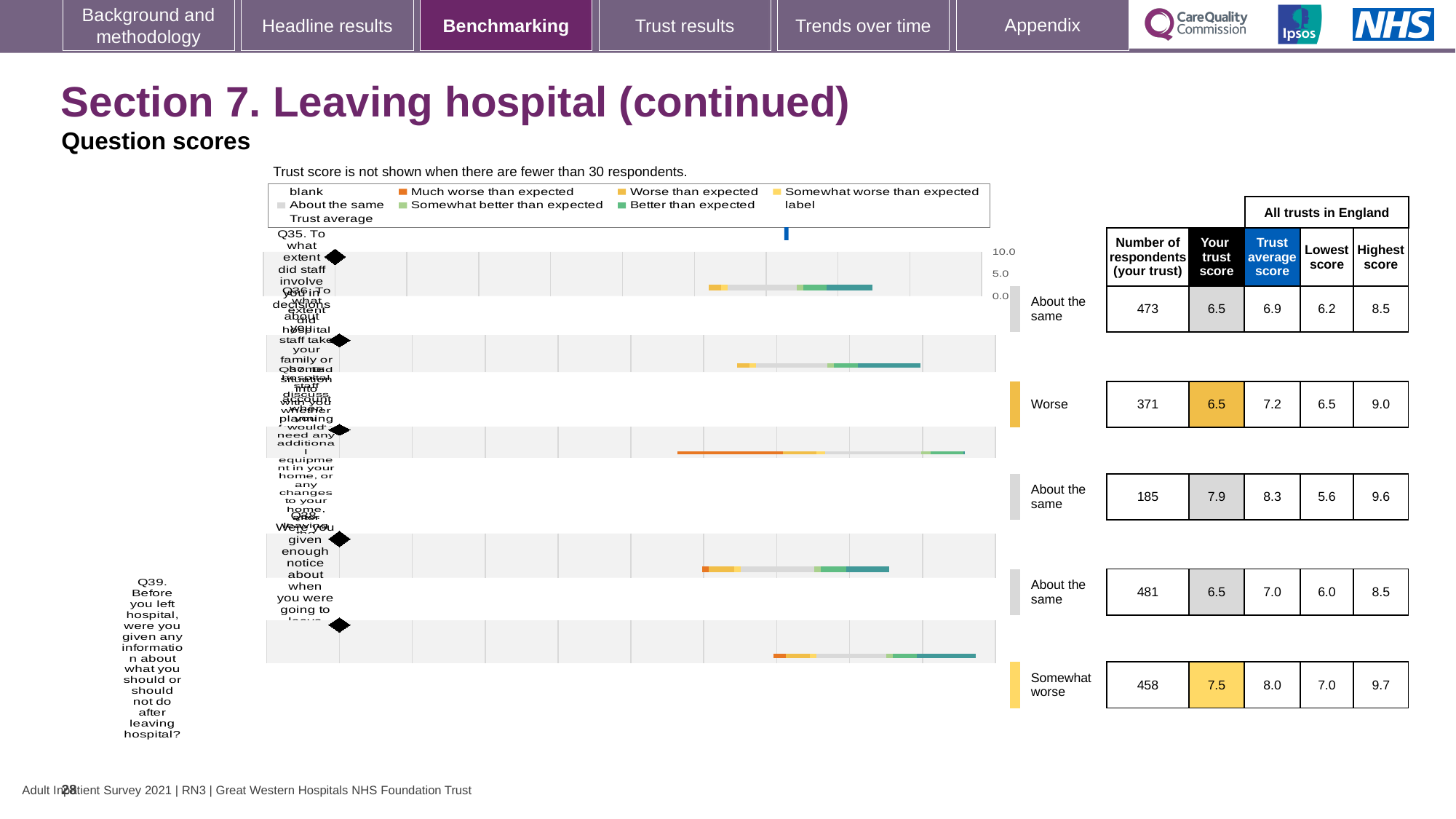
Which colour in the legend represents 'Much worse than expected'? orange What is the largest number of respondents shown for any question row? 481 What is the smallest number of respondents shown for any question row? 185 How many question rows are plotted in the chart? 5 What kind of chart is used to show the question scores on this slide? bar chart For Q39, which is larger: your trust score or the trust average score? trust average score What is the 'Your trust score' for Q39 (information about what you should or should not do after leaving hospital)? 7.5 For Q39, what is the difference between the trust average score and your trust score? 0.5 How many respondents are shown for Q39? 458 What is the lowest score for the question row rated 'Worse'? 6.5 What is the highest score across all trusts in England for Q39? 9.7 What benchmark rating is given to Q39? Somewhat worse